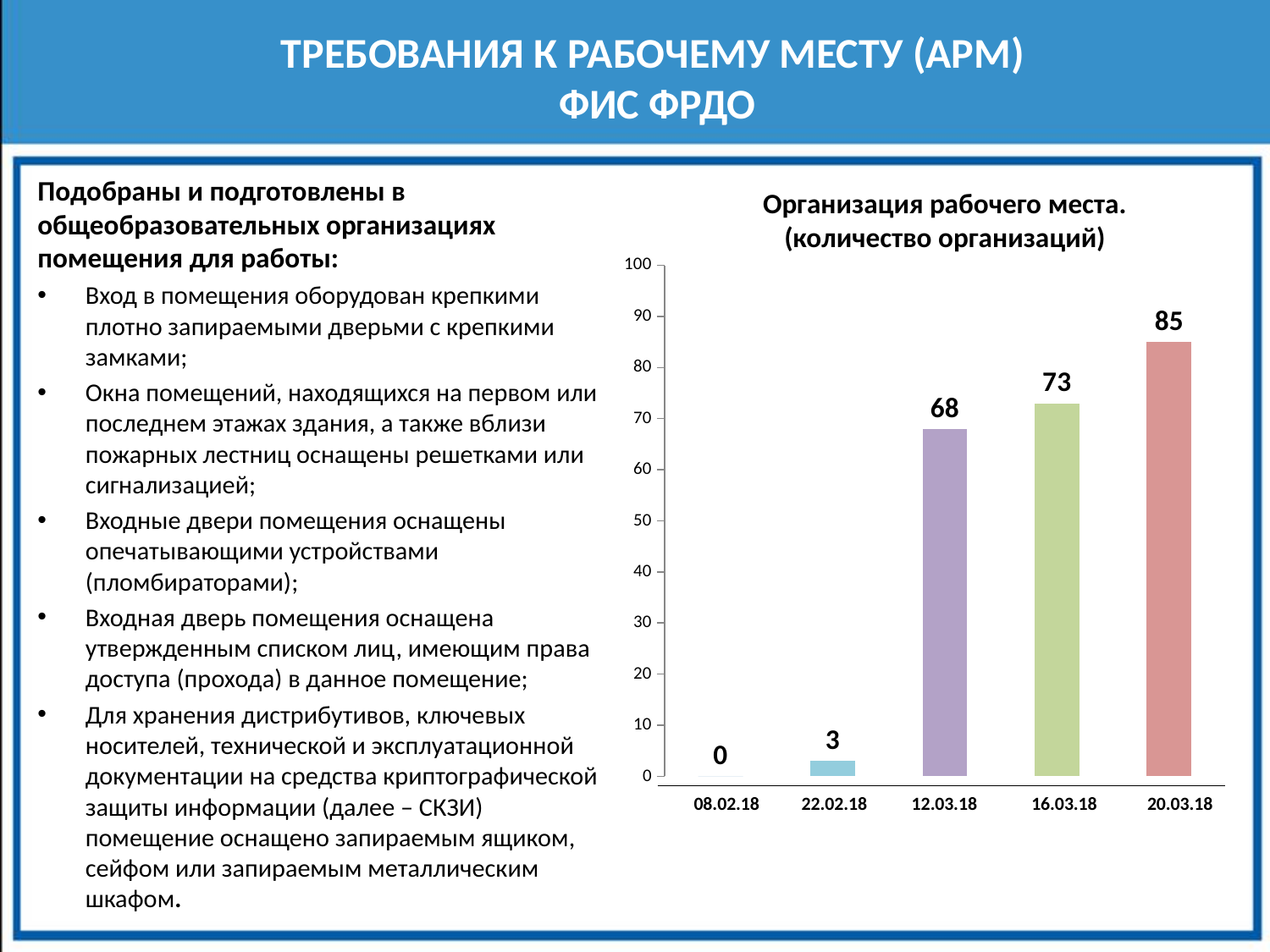
Which date has the highest value? 20.03.18 What is the value for 22.02.18? 3 How many dates are shown on the x axis? 5 Do the values rise or fall from 08.02.18 to 20.03.18? rise What is the value for 20.03.18? 85 Which is larger, the value for 12.03.18 or the value for 16.03.18? 16.03.18 What is the difference between the values for 20.03.18 and 16.03.18? 12 Is the value for 16.03.18 greater or less than 70? greater What is the title of the chart? Организация рабочего места. (количество организаций) Which date has the lowest value? 08.02.18 What is the value for 12.03.18? 68 What kind of chart is shown on the slide? bar chart